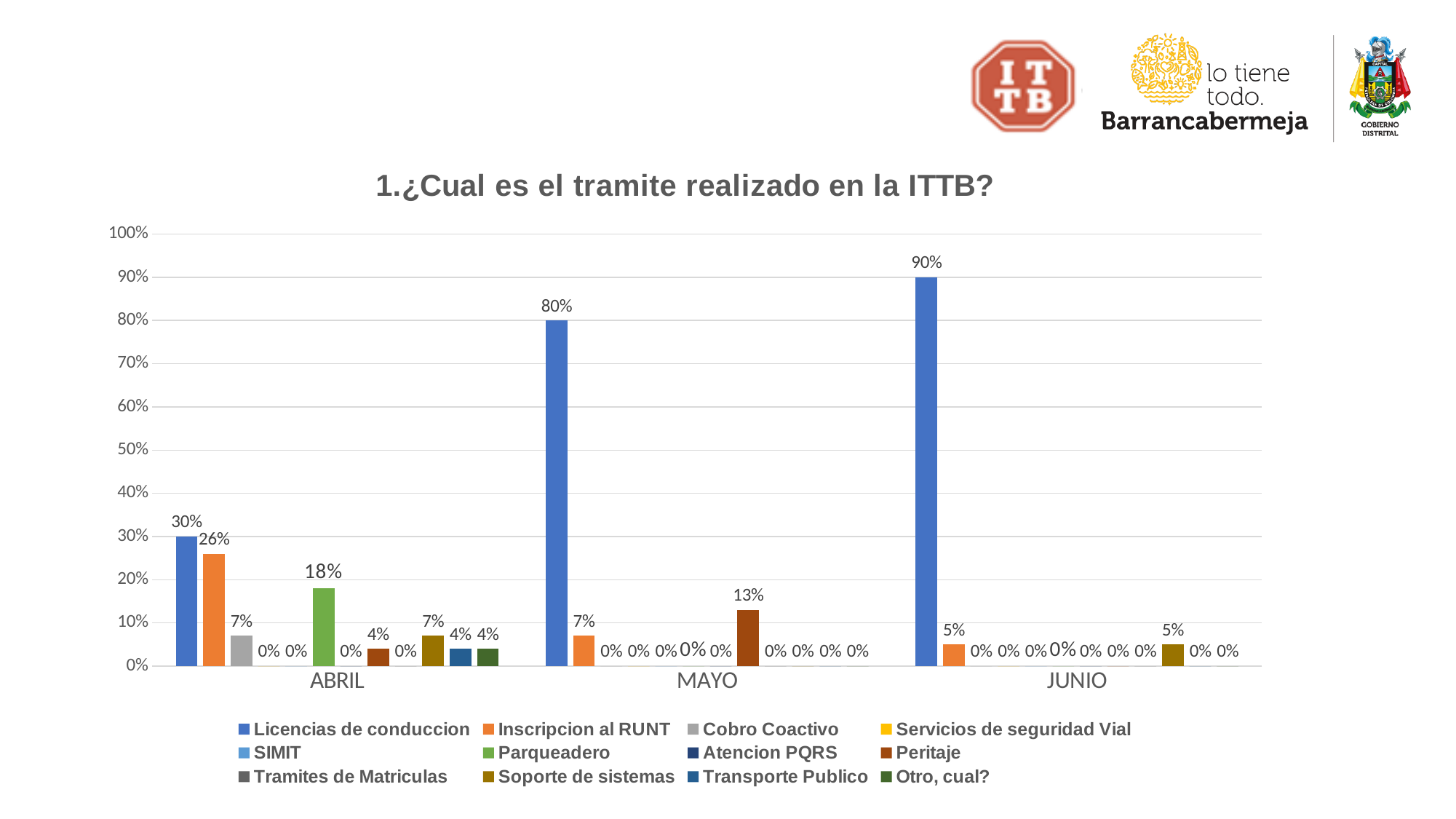
How many series does the legend list? 12 In which month is the value for Licencias de conduccion highest? JUNIO What kind of chart is shown on the slide? bar chart What is the difference between Licencias de conduccion and Inscripcion al RUNT in ABRIL? 4% What is the difference between Licencias de conduccion in JUNIO and in MAYO? 10% Does the value for Licencias de conduccion rise or fall from ABRIL to JUNIO? rise Which is larger in ABRIL, Parqueadero or Cobro Coactivo? Parqueadero What is the value for Parqueadero in ABRIL? 18% What is the value for Licencias de conduccion in MAYO? 80% What is the value for Peritaje in MAYO? 13% How many months are shown on the x axis? 3 What is the value for Inscripcion al RUNT in JUNIO? 5%